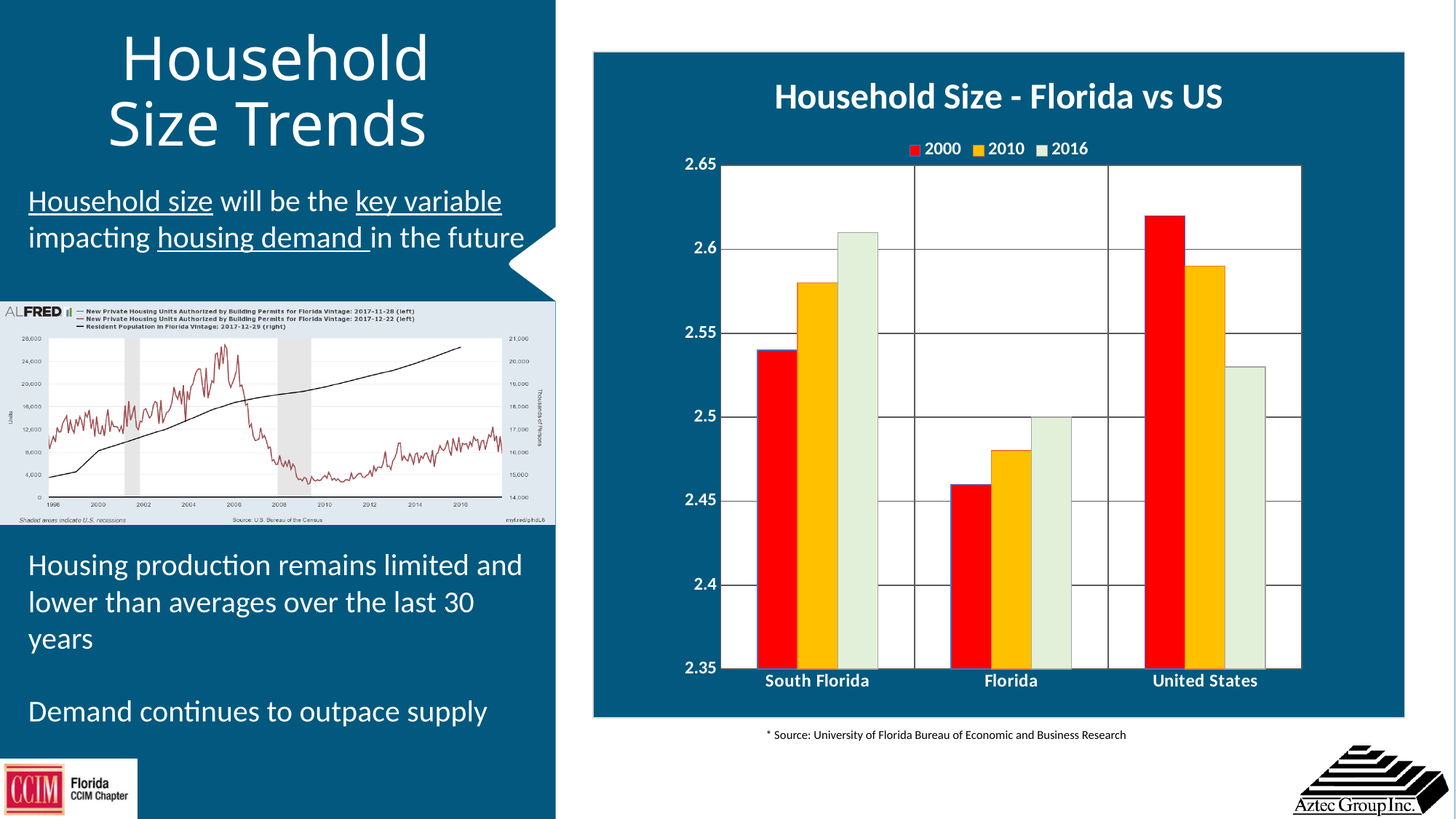
In the 'Household Size - Florida vs US' chart, is the 2000 value for Florida greater or less than 2.5? less In the 'Household Size - Florida vs US' chart, what kind of chart is shown? bar chart In the 'Household Size - Florida vs US' chart, which colour represents the 2010 series? orange In the 'Household Size - Florida vs US' chart, how many series does the legend list? 3 In the 'Household Size - Florida vs US' chart, is the 2000 value for United States greater or less than 2.6? greater In the 'Household Size - Florida vs US' chart, which category has the highest value for 2000? United States In the 'Household Size - Florida vs US' chart, is the 2016 value for South Florida greater or less than 2.6? greater In the 'Household Size - Florida vs US' chart, do the values for South Florida rise or fall from 2000 to 2016? rise In the 'Household Size - Florida vs US' chart, which category has the lowest value for 2016? Florida In the 'Household Size - Florida vs US' chart, which is larger for United States: the 2000 value or the 2016 value? 2000 In the 'Household Size - Florida vs US' chart, do the values for United States rise or fall from 2000 to 2016? fall In the 'Household Size - Florida vs US' chart, how many categories are shown on the x axis? 3